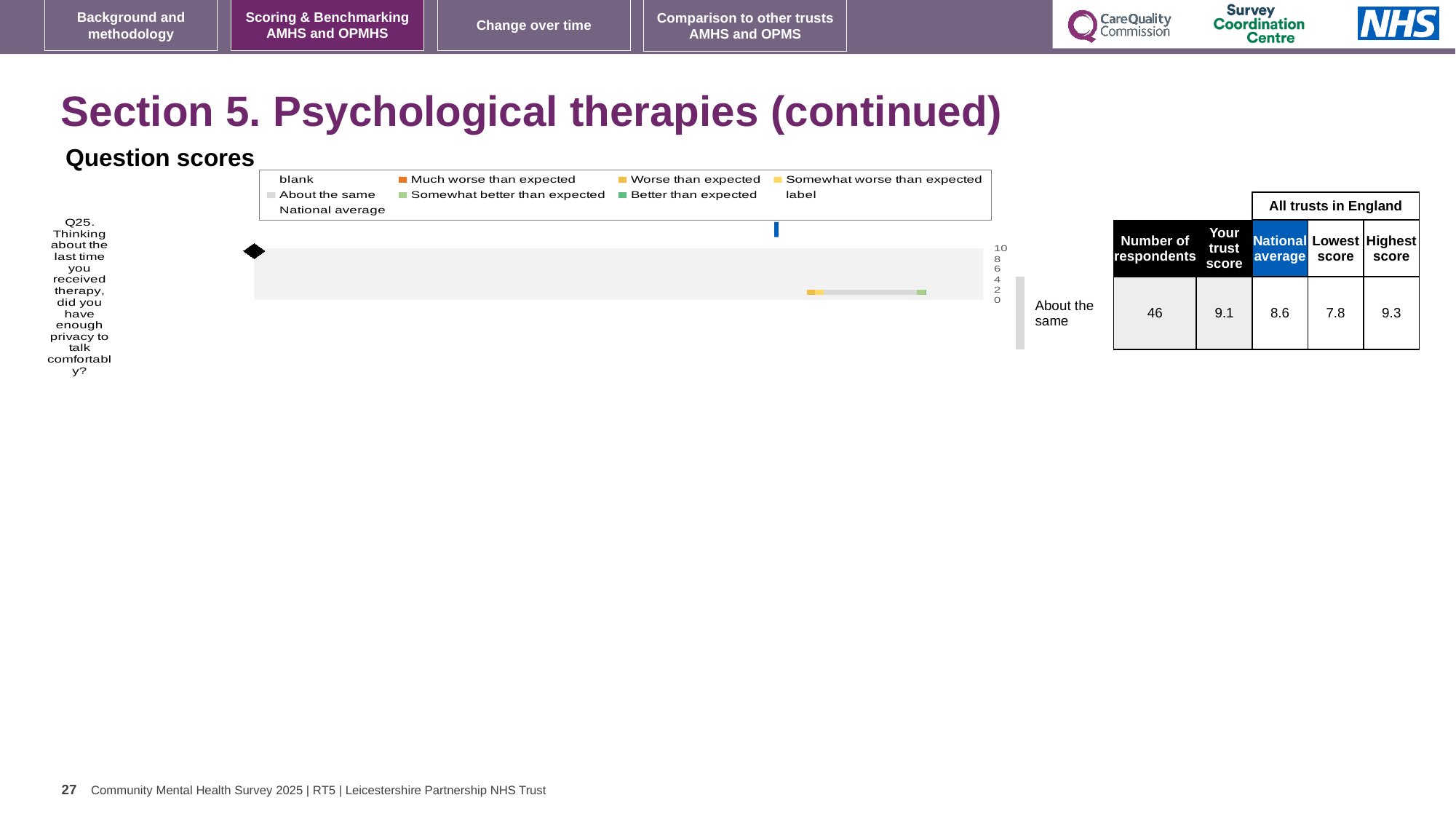
What kind of chart is shown under 'Question scores'? bar chart For Q25, is the trust's score higher or lower than the national average? higher In the table beside the chart, what is the trust's score for Q25? 9.1 What benchmark category is shown next to the chart for Q25? About the same In the table beside the chart, what is the highest score among all trusts in England for Q25? 9.3 For Q25, what is the difference between the highest score and the lowest score among all trusts in England? 1.5 How many questions (categories) are plotted in the Question scores chart? 1 What is the highest value shown on the chart's score axis? 10 In the table beside the chart, what is the national average for Q25? 8.6 Which question is plotted in the Question scores chart? Q25. Thinking about the last time you received therapy, did you have enough privacy to talk comfortably? In the table beside the chart, how many respondents answered Q25? 46 In the table beside the chart, what is the lowest score among all trusts in England for Q25? 7.8